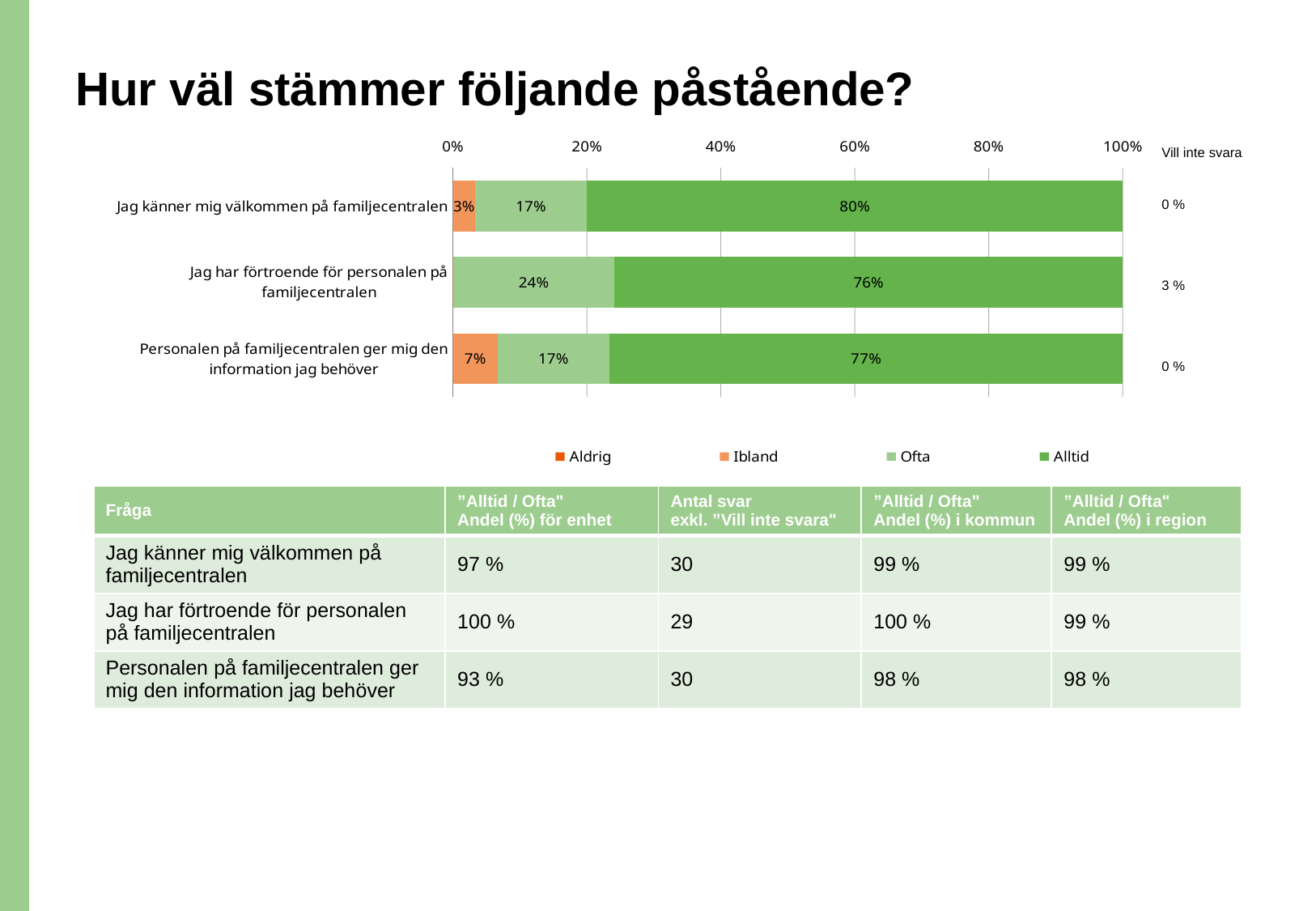
What is the "Ibland" value for "Personalen på familjecentralen ger mig den information jag behöver"? 7% What kind of chart is shown on the slide? Stacked bar chart Which is larger: the "Ofta" value for "Jag har förtroende för personalen på familjecentralen" or the "Ofta" value for "Jag känner mig välkommen på familjecentralen"? Jag har förtroende för personalen på familjecentralen What is the "Alltid" value for "Jag känner mig välkommen på familjecentralen"? 80% Which statement has the highest "Alltid" value? Jag känner mig välkommen på familjecentralen How many statements (categories) are shown in the chart? 3 What is the difference between the "Alltid" values for "Jag känner mig välkommen på familjecentralen" and "Jag har förtroende för personalen på familjecentralen"? 4% How many series does the legend list? 4 What is the "Vill inte svara" value shown next to "Jag har förtroende för personalen på familjecentralen"? 3 % What is the "Ofta" value for "Jag har förtroende för personalen på familjecentralen"? 24% What is the "Alltid" value for "Personalen på familjecentralen ger mig den information jag behöver"? 77% Which statement has the lowest "Alltid" value? Jag har förtroende för personalen på familjecentralen